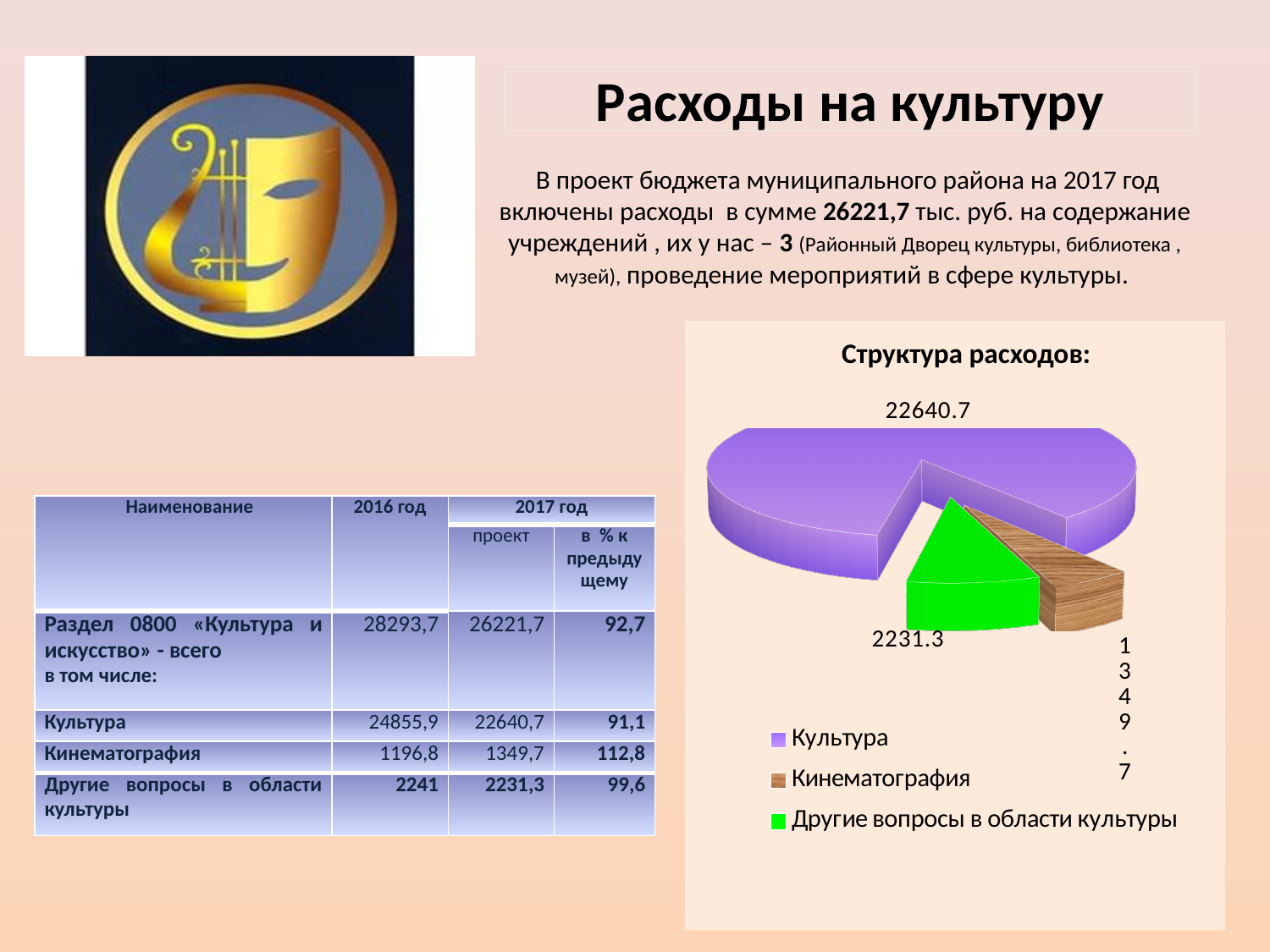
Which colour represents Другие вопросы в области культуры in the pie chart? green Which category has the largest slice in the pie chart? Культура Which category has the smallest slice in the pie chart? Кинематография How many slices does the pie chart have? 3 What is the title of the chart on the slide? Структура расходов: What value is shown for Культура in the pie chart? 22640.7 In the pie chart, which is larger: Кинематография or Другие вопросы в области культуры? Другие вопросы в области культуры What value is shown for Кинематография in the pie chart? 1349.7 What value is shown for Другие вопросы в области культуры in the pie chart? 2231.3 What is the difference between the values for Культура and Другие вопросы в области культуры in the pie chart? 20409.4 What kind of chart is shown under the title "Структура расходов:"? pie chart How many entries does the legend of the pie chart list? 3